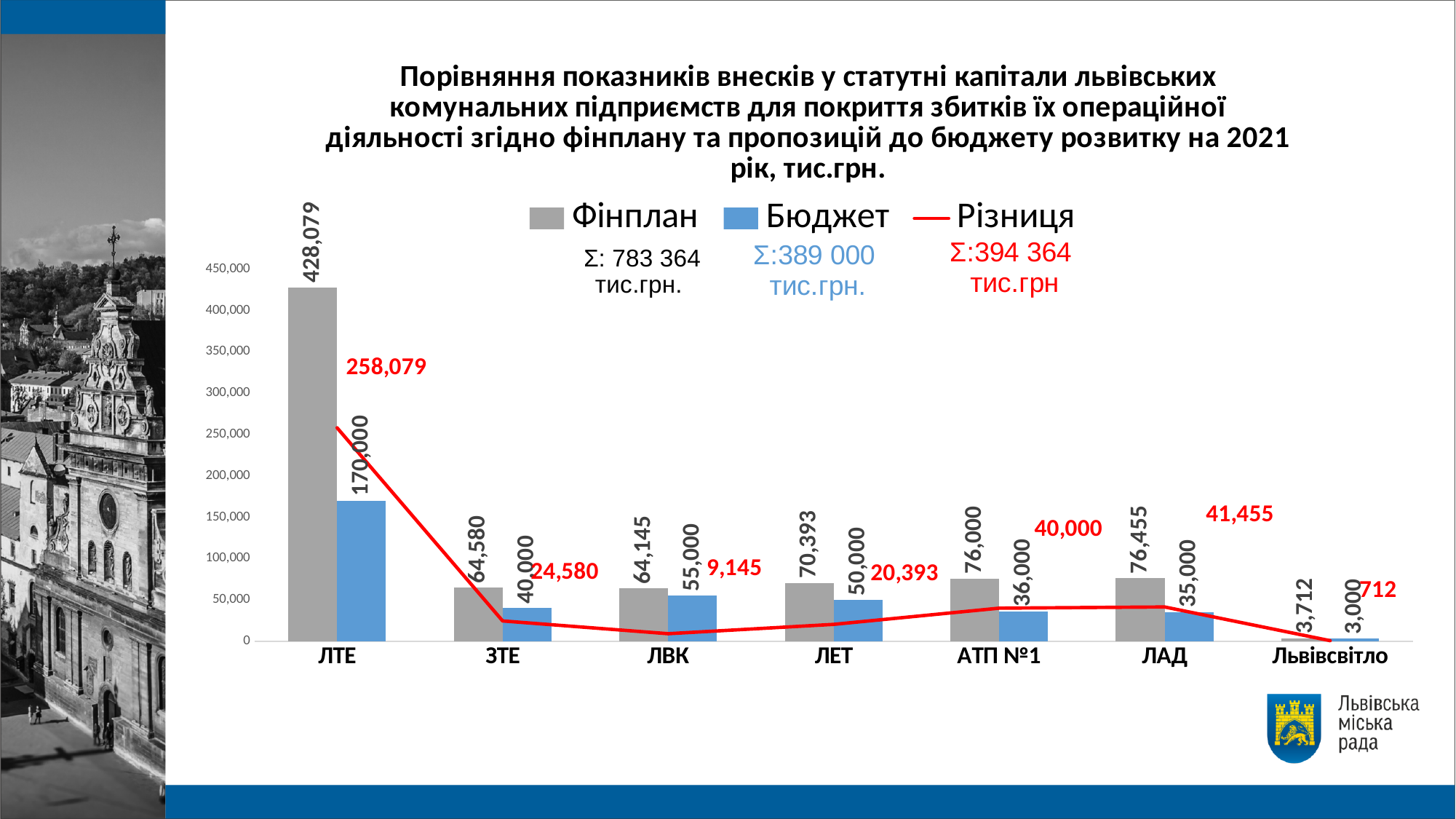
What is the Бюджет value for ЛВК? 55,000 Which category has the highest Фінплан value? ЛТЕ What total is shown for the Бюджет series? 389 000 тис.грн. How many series does the legend list? 3 What is the Фінплан value for Львівсвітло? 3,712 How many categories are shown on the x axis? 7 What is the Різниця value for АТП №1? 40,000 What kind of chart is this? Combined bar and line chart Which category has the lowest Бюджет value? Львівсвітло What is the difference between the Фінплан and Бюджет values for ЛЕТ? 20,393 Which is larger, the Бюджет value for ЗТЕ or the Бюджет value for АТП №1? ЗТЕ What is the Фінплан value for ЛТЕ? 428,079